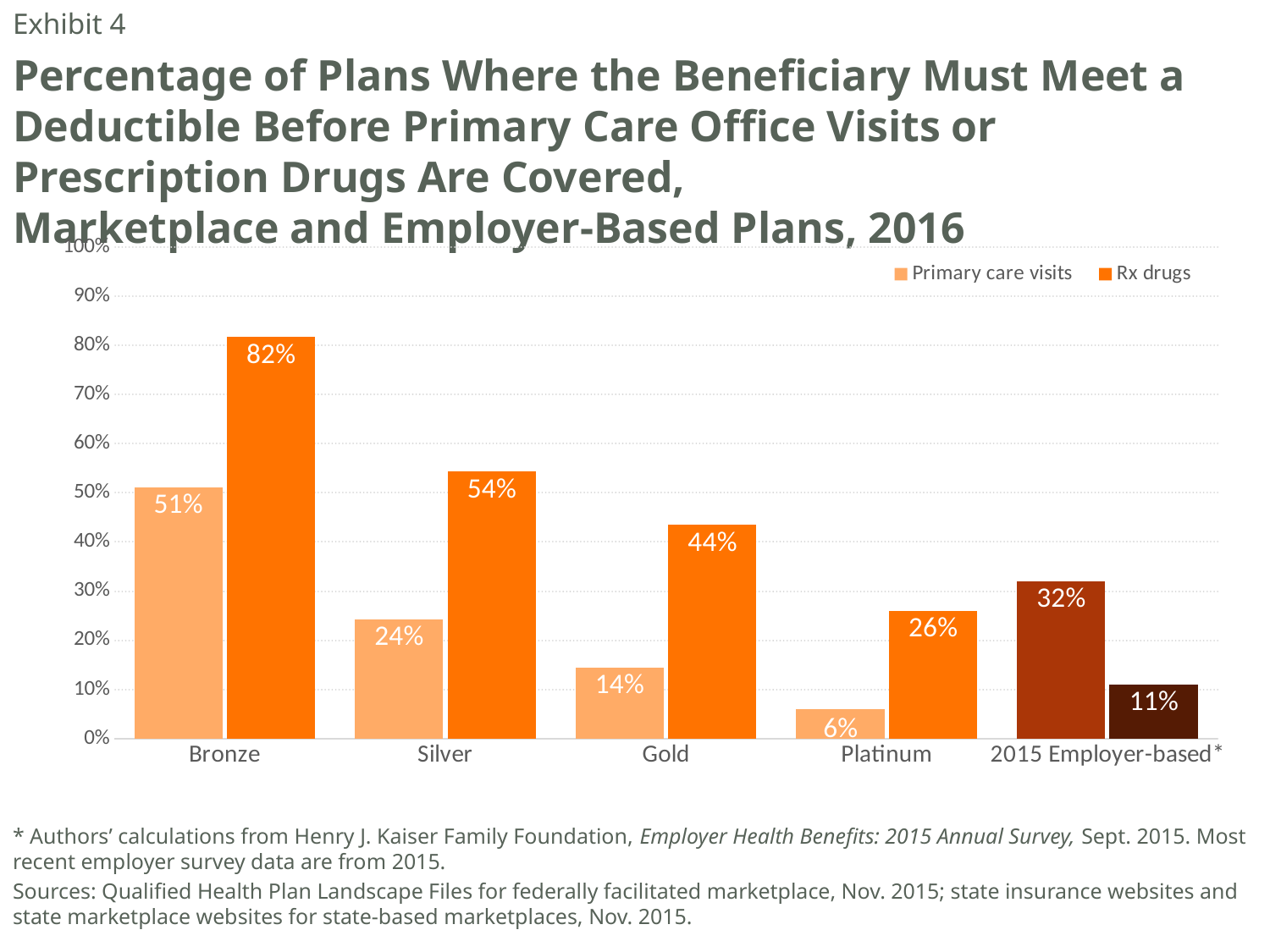
What are the two series listed in the legend? Primary care visits and Rx drugs How many categories are shown on the x axis? 5 Which category has the highest Rx drugs value? Bronze What is the value for Rx drugs for Bronze plans? 82% What is the value for Primary care visits for 2015 Employer-based plans? 32% How many series does the legend list? 2 What is the value for Primary care visits for Silver plans? 24% Do the Rx drugs values rise or fall from Bronze to Platinum? Fall What kind of chart is shown on the slide? Bar chart Which is larger for 2015 Employer-based plans: Primary care visits or Rx drugs? Primary care visits What is the difference between the Rx drugs value and the Primary care visits value for Gold plans? 30% Which category has the lowest Primary care visits value? Platinum